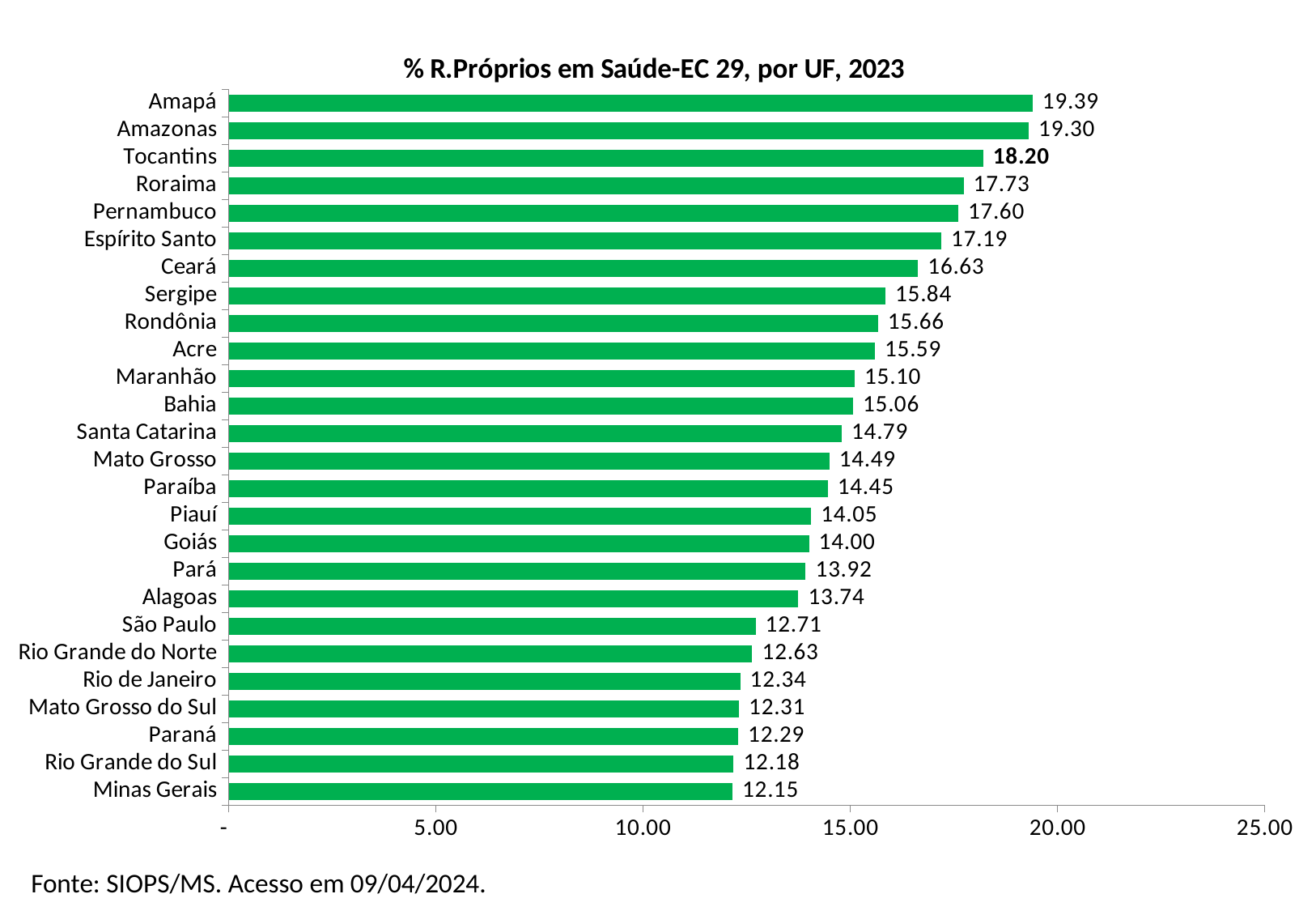
Which UF has the lowest value? Minas Gerais Which has a larger value, Pernambuco or Sergipe? Pernambuco What is the value for Rio Grande do Norte? 12.63 What is the difference between the values for Amapá and Minas Gerais? 7.24 What is the value for Santa Catarina? 14.79 Is the value for Ceará greater or less than 15.00? greater What is the difference between the values for Tocantins and Ceará? 1.57 How many UFs are shown in the chart? 26 What is the title of the chart? % R.Próprios em Saúde-EC 29, por UF, 2023 Which UF has the highest value? Amapá What is the value for Tocantins? 18.20 What kind of chart is shown on the slide? bar chart